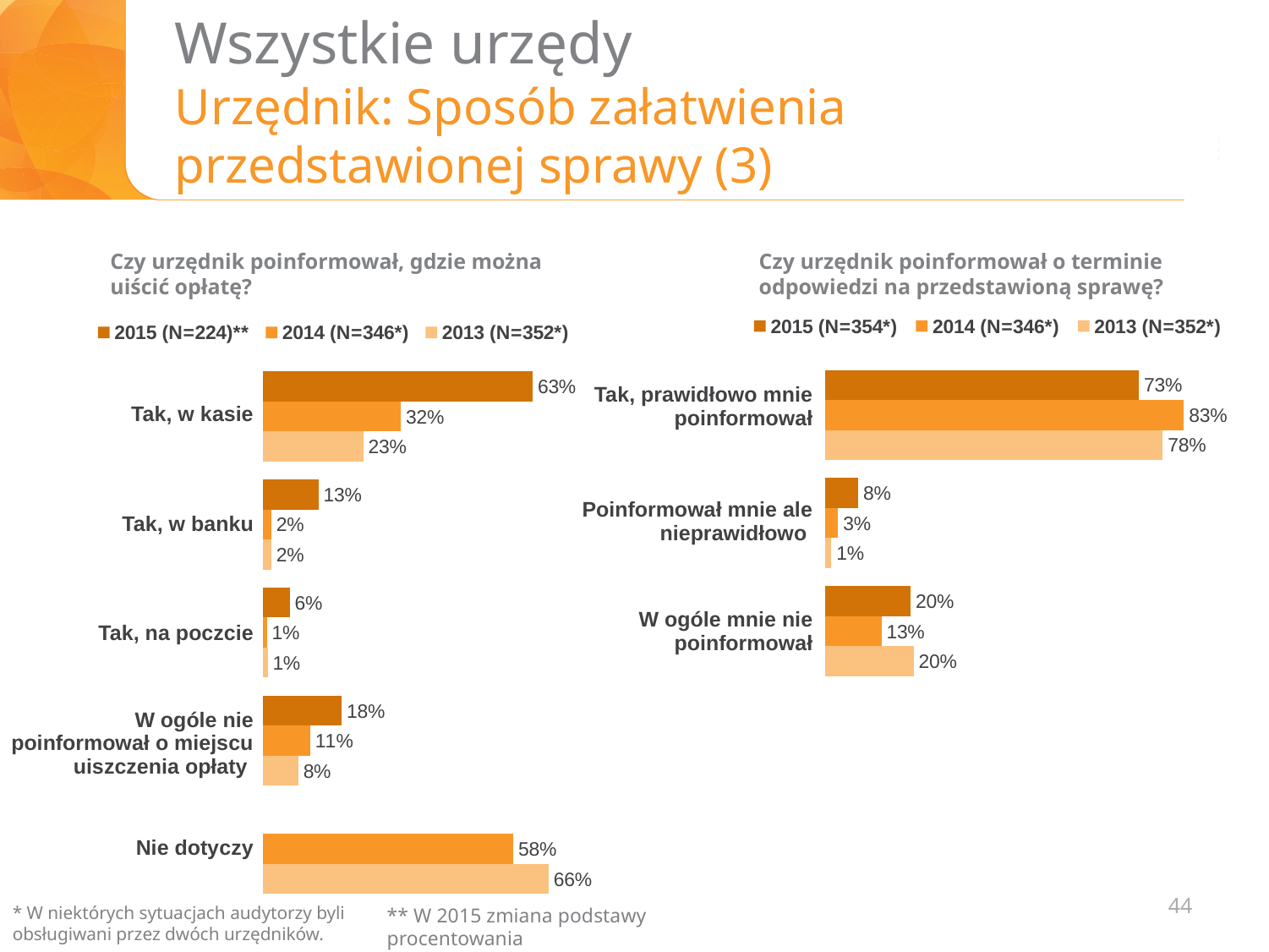
In the right chart ("Czy urzędnik poinformował o terminie odpowiedzi na przedstawioną sprawę?"), which year has the lowest value for "Poinformował mnie ale nieprawidłowo"? 2013 (N=352*) In the left chart ("Czy urzędnik poinformował, gdzie można uiścić opłatę?"), how many series does the legend list? 3 In the right chart ("Czy urzędnik poinformował o terminie odpowiedzi na przedstawioną sprawę?"), what is the difference between the 2014 and 2015 values for "Tak, prawidłowo mnie poinformował"? 10 percentage points In the left chart ("Czy urzędnik poinformował, gdzie można uiścić opłatę?"), what is the 2015 value for "Tak, w kasie"? 63% In the left chart ("Czy urzędnik poinformował, gdzie można uiścić opłatę?"), how many categories are shown? 5 In the right chart ("Czy urzędnik poinformował o terminie odpowiedzi na przedstawioną sprawę?"), is the 2015 value for "W ogóle mnie nie poinformował" larger or smaller than the 2014 value? larger In the left chart ("Czy urzędnik poinformował, gdzie można uiścić opłatę?"), which category has the highest 2015 value? Tak, w kasie In the left chart ("Czy urzędnik poinformował, gdzie można uiścić opłatę?"), what is the 2013 value for "Nie dotyczy"? 66% What type of chart is the right chart ("Czy urzędnik poinformował o terminie odpowiedzi na przedstawioną sprawę?")? Bar chart In the right chart ("Czy urzędnik poinformował o terminie odpowiedzi na przedstawioną sprawę?"), what is the sample size (N) shown in the legend for 2015? 354 In the right chart ("Czy urzędnik poinformował o terminie odpowiedzi na przedstawioną sprawę?"), what is the 2014 value for "Tak, prawidłowo mnie poinformował"? 83% In the left chart ("Czy urzędnik poinformował, gdzie można uiścić opłatę?"), what is the difference between the 2015 and 2014 values for "Tak, w kasie"? 31 percentage points